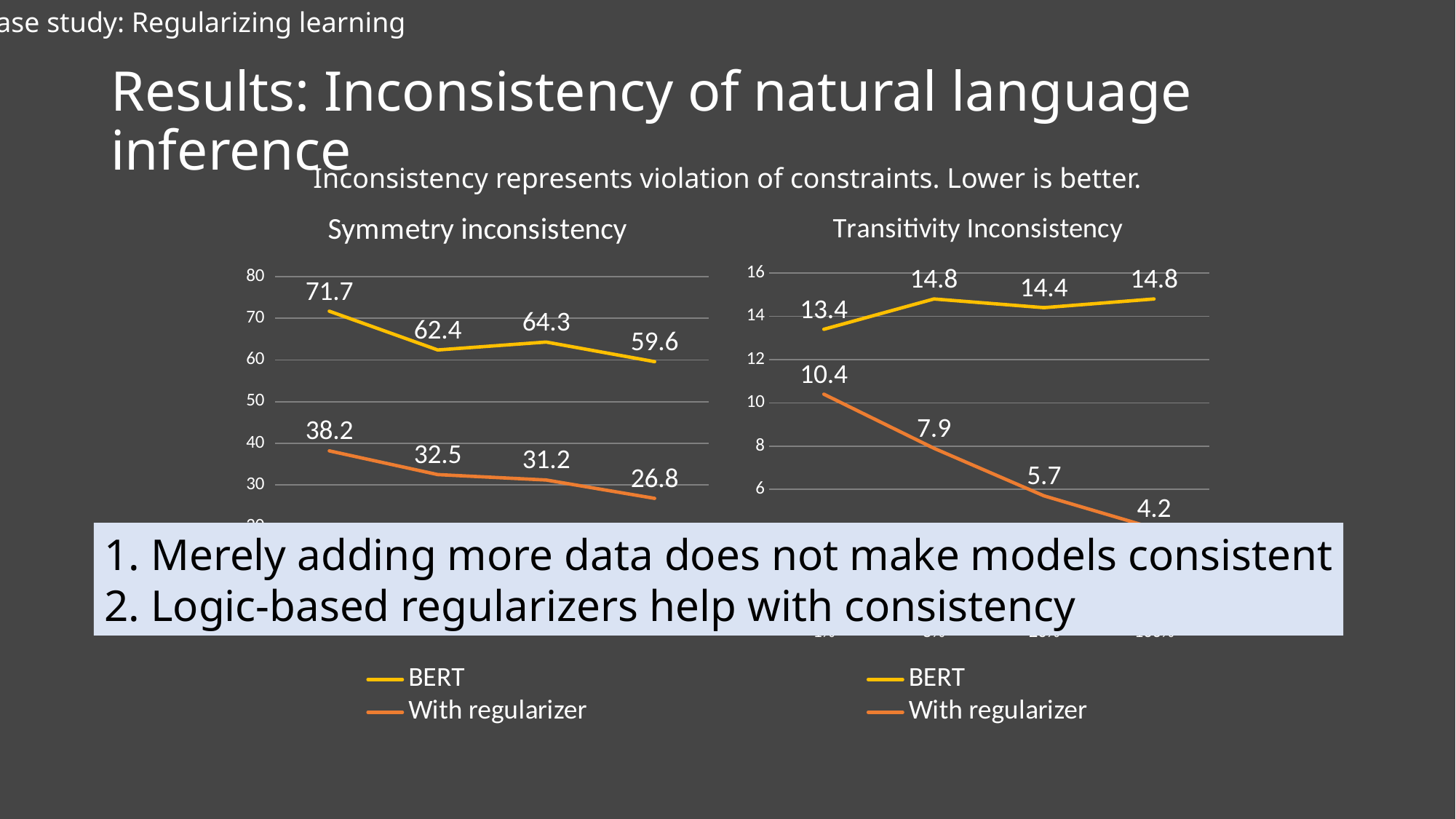
In the Transitivity Inconsistency chart, does the With regularizer series rise or fall along the x axis? Fall In the Transitivity Inconsistency chart, what is the first plotted value of the With regularizer series? 10.4 In the Symmetry inconsistency chart, what is the highest value of the BERT series? 71.7 How many series does the legend of the Transitivity Inconsistency chart list? 2 In the Transitivity Inconsistency chart, which series has the higher last plotted value, BERT or With regularizer? BERT In the Symmetry inconsistency chart, what is the first plotted value of the BERT series? 71.7 What type of chart is the Symmetry inconsistency chart? Line chart In the Transitivity Inconsistency chart, what is the difference between the last BERT value and the last With regularizer value? 10.6 How many data points does each series have in the Symmetry inconsistency chart? 4 In the Transitivity Inconsistency chart, what is the lowest value of the With regularizer series? 4.2 In the Symmetry inconsistency chart, what is the last plotted value of the With regularizer series? 26.8 In the Symmetry inconsistency chart, what is the difference between the first BERT value and the first With regularizer value? 33.5